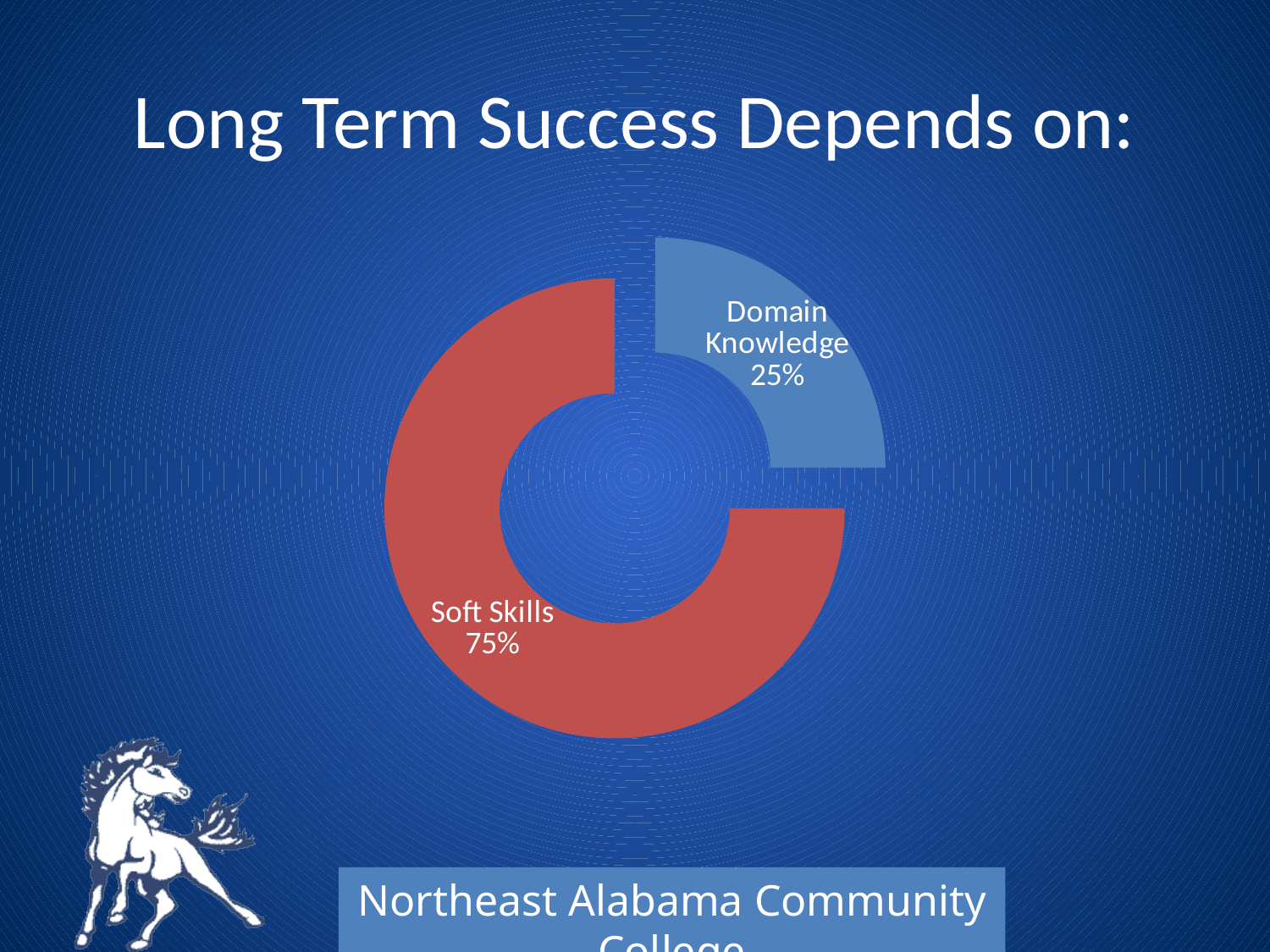
What percentage does the chart show for Soft Skills? 75% What share of the chart does the Domain Knowledge slice represent? 25% What colour is the Soft Skills segment of the chart? Red What is the difference in percentage points between Soft Skills and Domain Knowledge? 50 What kind of chart is shown on the slide? Doughnut chart What percentage does the chart show for Domain Knowledge? 25% Which category has the largest share in the chart? Soft Skills Which category has the smallest share in the chart? Domain Knowledge How many categories are shown in the chart? 2 What is the title of the slide containing the chart? Long Term Success Depends on: Which is larger, the share for Soft Skills or the share for Domain Knowledge? Soft Skills